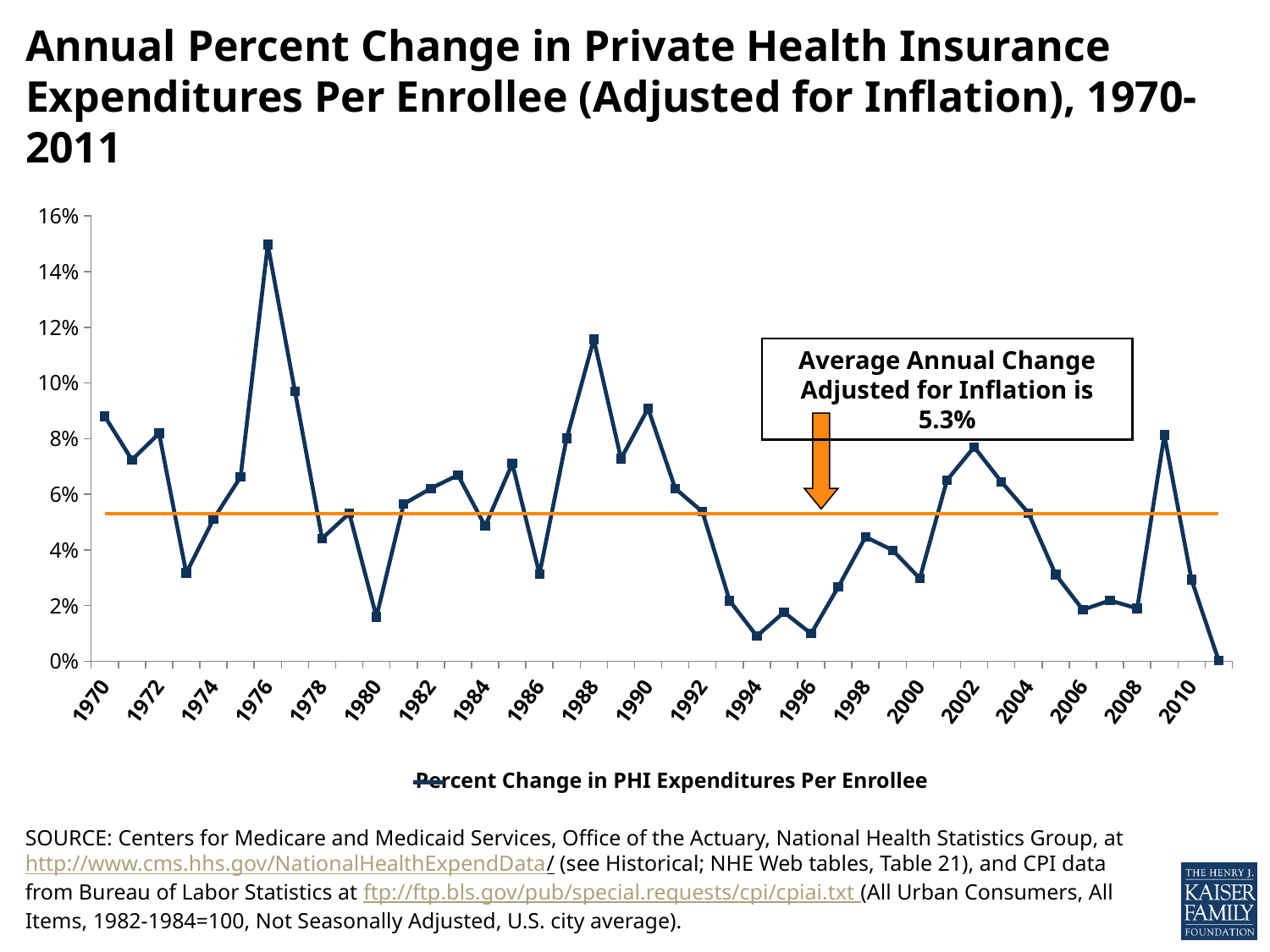
Which year has the highest percent change in PHI expenditures per enrollee? 1976 Is the value for 1988 greater or less than 10%? greater Is the value for 2002 greater or less than 6%? greater Which year has the larger percent change, 1976 or 1988? 1976 Do the values rise or fall from 1976 to 1980? fall What is the name of the series shown in the legend? Percent Change in PHI Expenditures Per Enrollee Is the value for 1976 greater or less than 14%? greater Which year has the lowest percent change in PHI expenditures per enrollee? 2011 What kind of chart is shown on the slide? line chart How many series does the legend list? 1 What is the average annual change adjusted for inflation stated on the chart? 5.3%